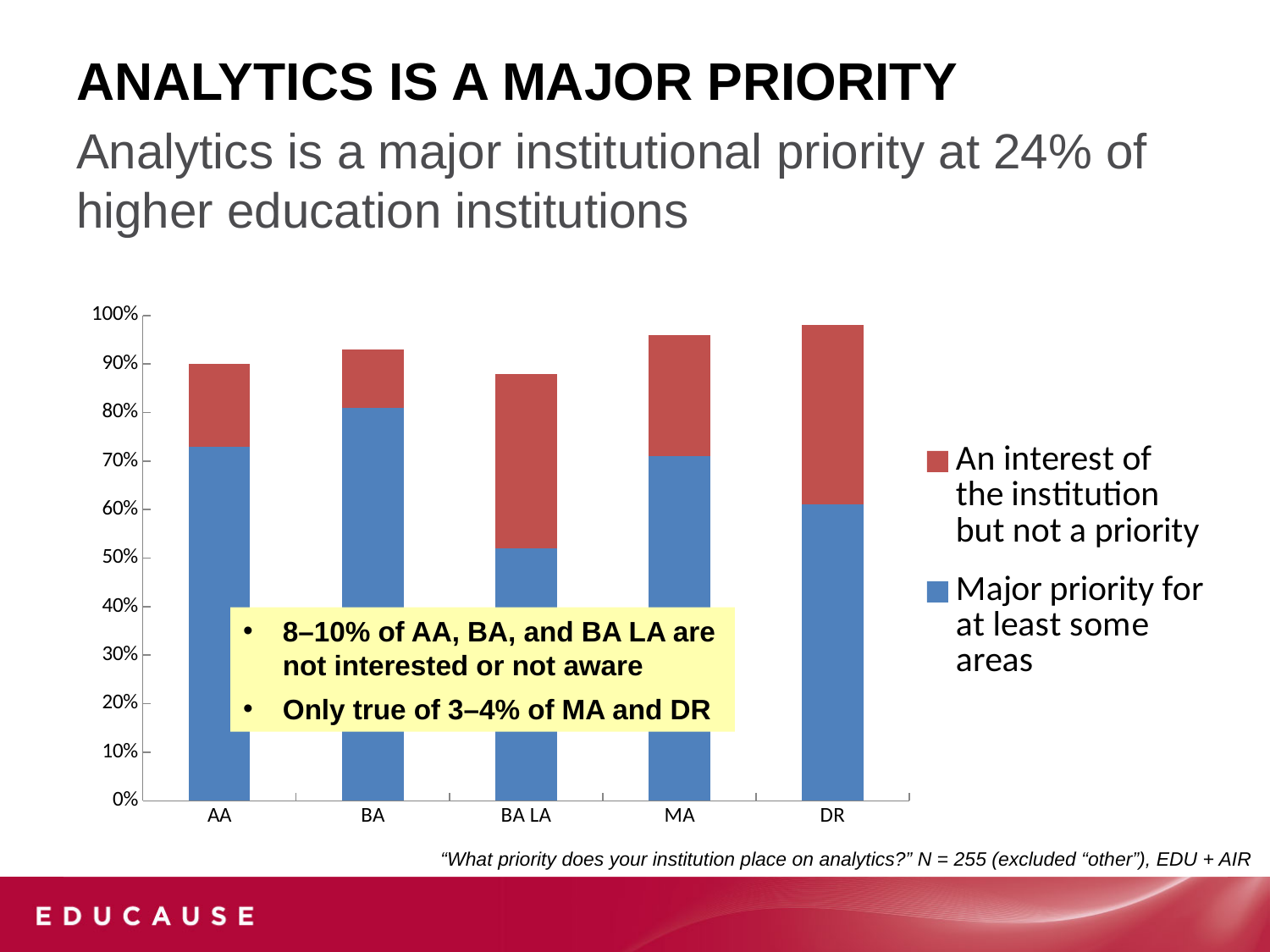
How many institution categories are shown on the x axis of the chart? 5 Is the total height of the stacked bar for MA greater or less than 90%? greater Is the 'Major priority for at least some areas' value for AA greater or less than 60%? greater Which category has the smallest 'Major priority for at least some areas' segment? BA LA What kind of chart is shown on the slide? stacked bar chart Which colour represents 'An interest of the institution but not a priority' in the chart? red Which has a larger 'Major priority for at least some areas' value, BA or BA LA? BA How many series does the chart legend list? 2 Which has a larger 'Major priority for at least some areas' value, AA or DR? AA Which category has the largest 'Major priority for at least some areas' segment? BA Is the 'Major priority for at least some areas' value for DR greater or less than 70%? less